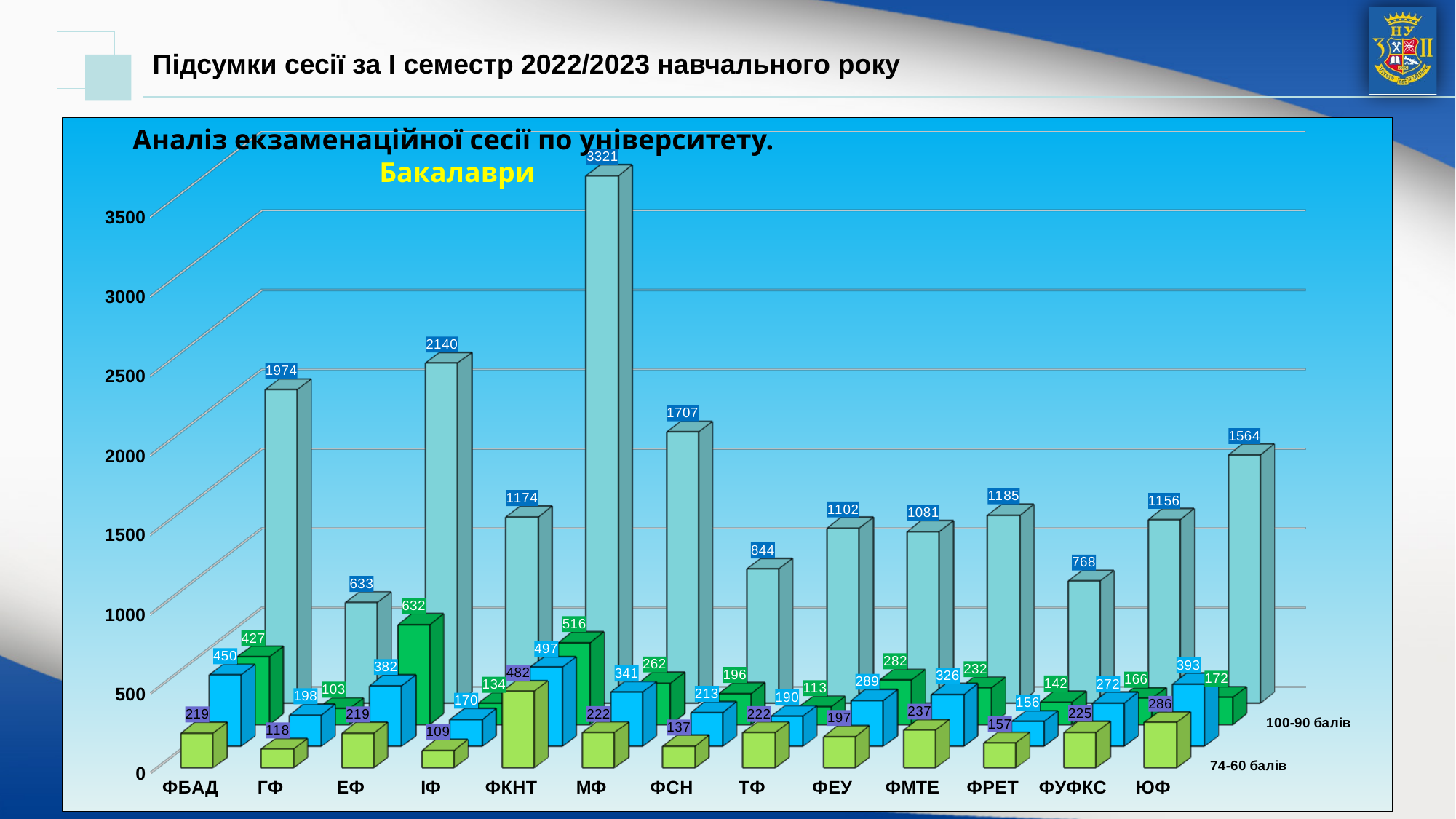
What is the value of the blue bar for ФБАД? 450 How many faculties (categories) are shown along the x axis of the chart? 13 Which faculty has the larger teal bar value, ФБАД or МФ? ФБАД What is the value of the dark green bar for ЕФ? 632 What kind of chart is shown on the slide? bar chart Is the teal bar value for ФСН greater or less than 1000? less Which faculty has the highest value among the tall teal bars? ФКНТ What is the difference between the teal bar values for ФКНТ and ЕФ? 1181 What is the value of the tall teal bar for ЮФ? 1564 Which faculty has the lowest value among the tall teal bars? ГФ What subtitle is shown in yellow below the chart title? Бакалаври What is the value of the light green front bar for ФКНТ? 482